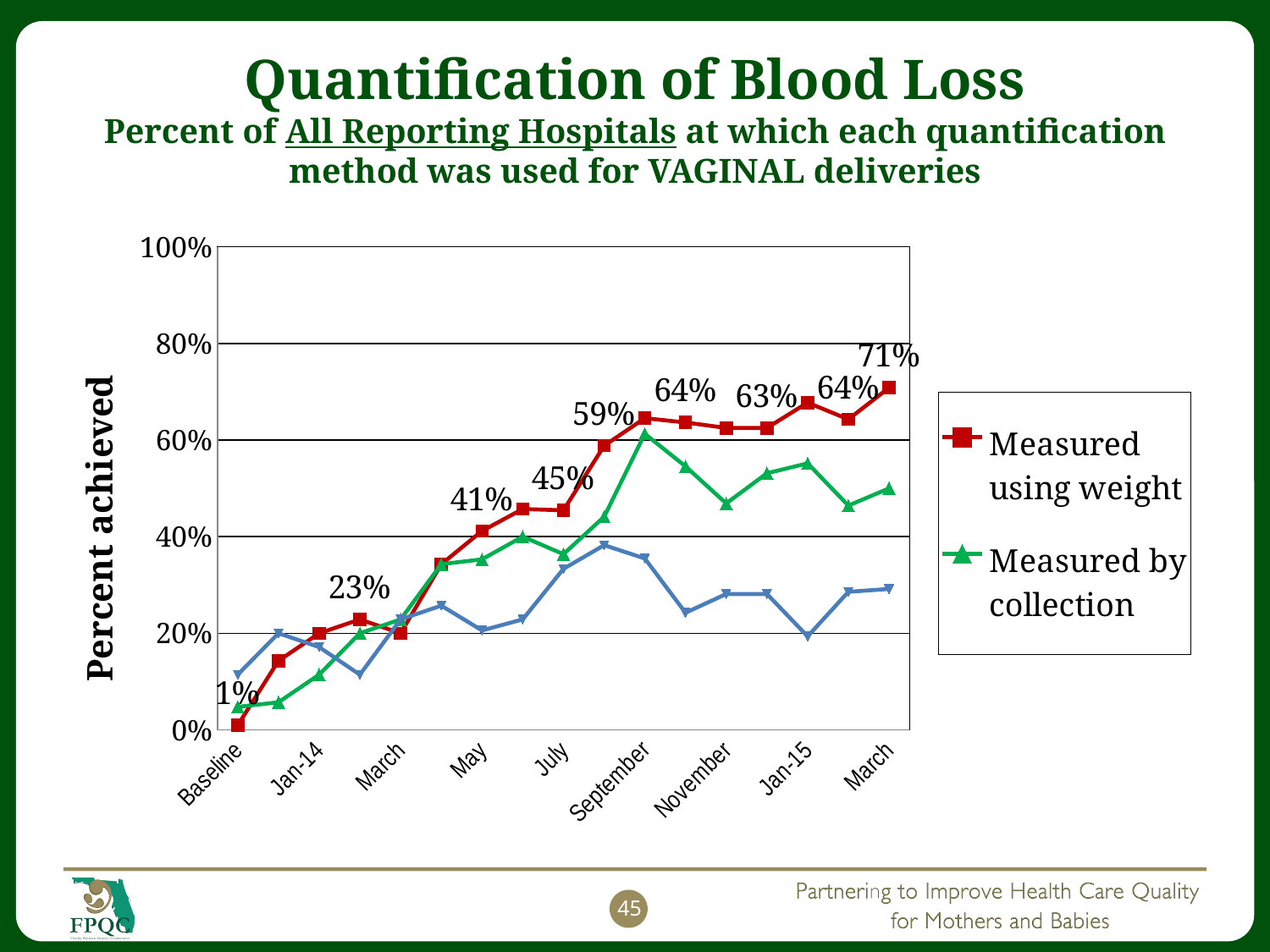
At which x-axis point does the Measured using weight series reach its highest value? March (after Jan-15) Is the value for Measured by collection at the final March point greater or less than 40%? greater At the final March point, which series is higher: Measured using weight or Measured by collection? Measured using weight What is the difference between the Measured using weight values at the final March point and at Baseline? 70 percentage points What kind of chart is shown on the slide? line chart How many series does the legend list? 2 What is the value for Measured using weight at Baseline? 1% Does the Measured using weight series generally rise or fall from Baseline to the final March point? rise What is the value for Measured using weight at the final March point (after Jan-15)? 71% What is the title of the y axis? Percent achieved At which x-axis point is the Measured using weight series lowest? Baseline Is the value for Measured by collection at Baseline greater or less than 20%? less